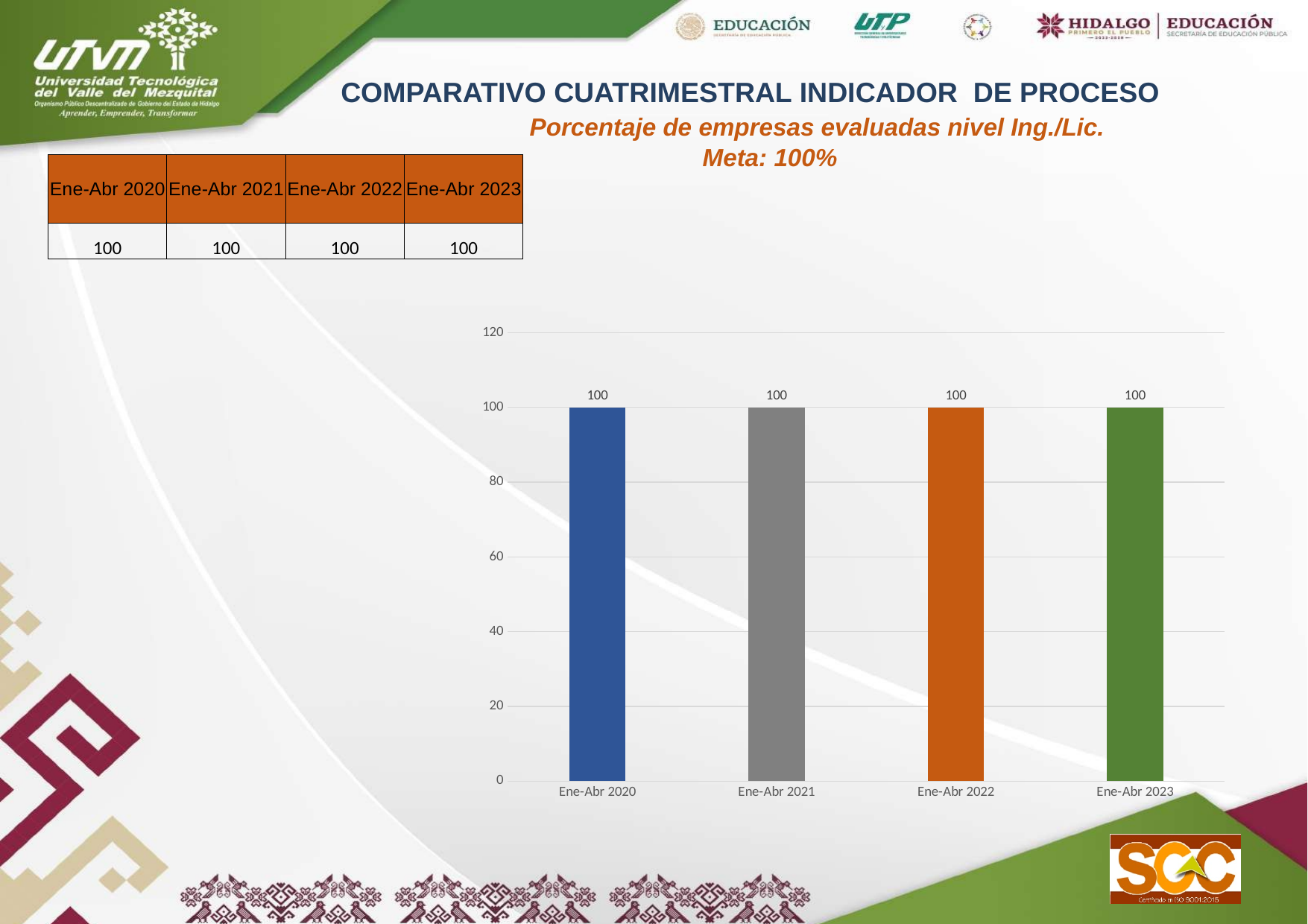
What kind of chart is shown on the slide? bar chart How many categories are shown on the x axis of the chart? 4 What is the highest value shown on the vertical axis of the chart? 120 Is the value for Ene-Abr 2021 greater or less than 120? less What is the value for Ene-Abr 2023? 100 Do the values rise, fall or stay the same from Ene-Abr 2020 to Ene-Abr 2023? stay the same What colour is the bar for Ene-Abr 2022? orange Is the value for Ene-Abr 2022 greater or less than 80? greater What is the value for Ene-Abr 2021? 100 What is the difference between the values for Ene-Abr 2022 and Ene-Abr 2020? 0 What is the value for Ene-Abr 2020? 100